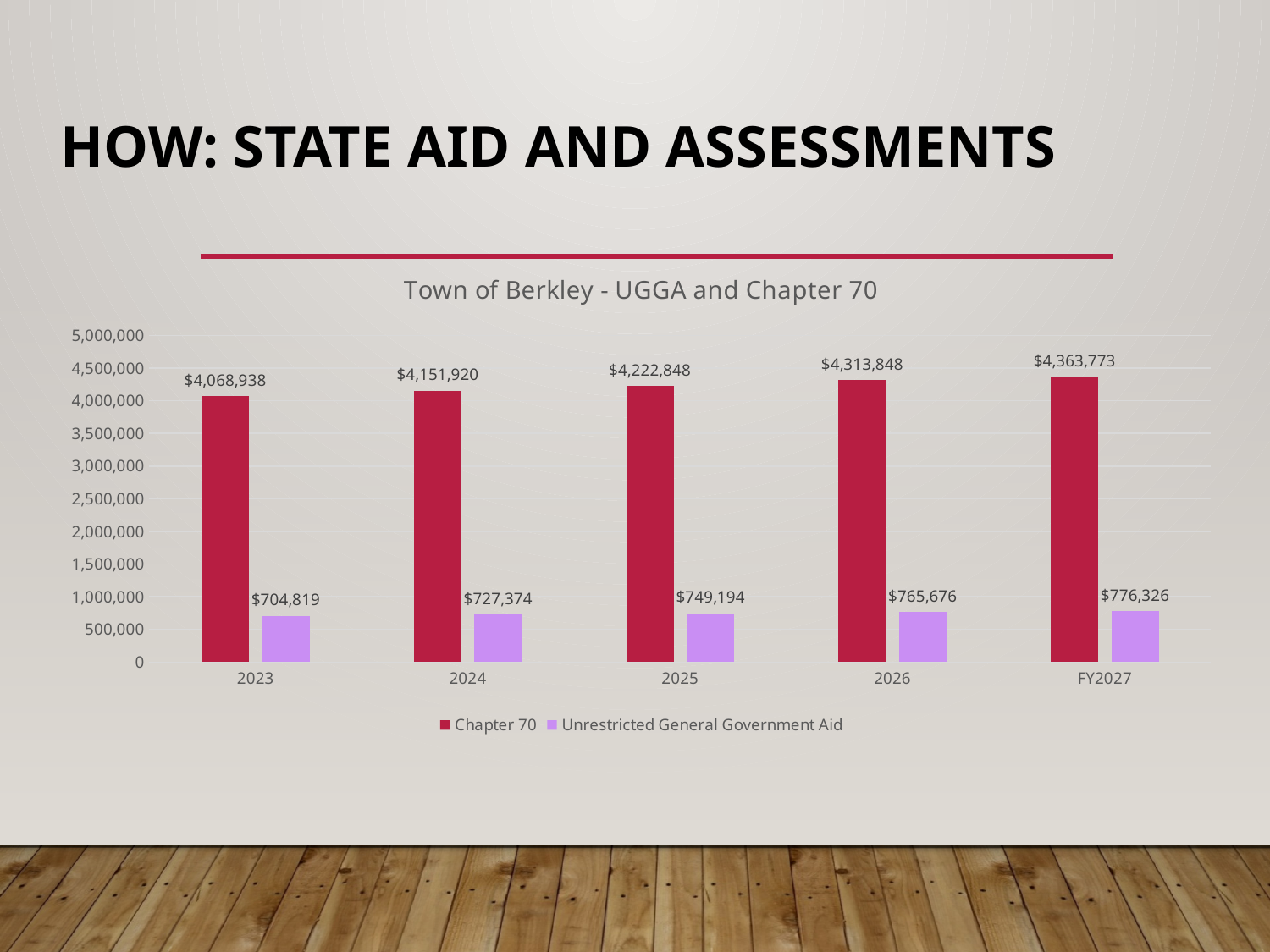
Which year has the highest Unrestricted General Government Aid value? FY2027 Is the Unrestricted General Government Aid value for 2024 greater or less than 1,000,000? less What is the difference between the Chapter 70 value for FY2027 and for 2023? $294,835 What is the difference between the Unrestricted General Government Aid values for 2024 and 2023? $22,555 How many years are shown on the x axis? 5 Do the Chapter 70 values rise or fall from 2023 to FY2027? rise What is the Unrestricted General Government Aid value for 2025? $749,194 What is the Chapter 70 value for FY2027? $4,363,773 How many series does the legend list? 2 Which year has the lowest Chapter 70 value? 2023 Which is larger in 2026: Chapter 70 or Unrestricted General Government Aid? Chapter 70 What is the Chapter 70 value for 2023? $4,068,938